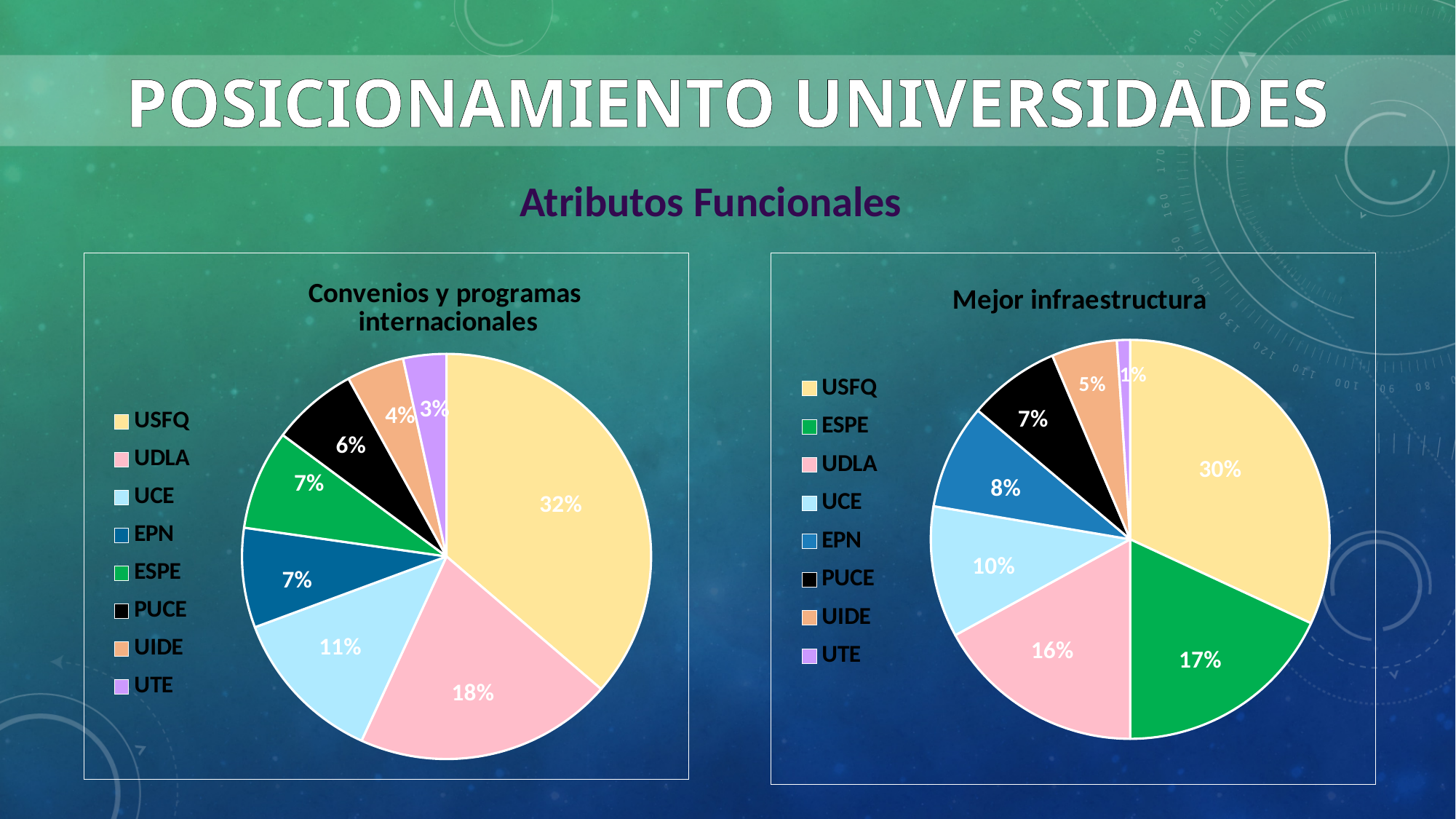
In the 'Mejor infraestructura' chart, what is the difference between the USFQ share and the UDLA share? 14% What kind of chart is 'Convenios y programas internacionales'? Pie chart In the 'Convenios y programas internacionales' chart, which is larger, the UDLA share or the UCE share? UDLA In the 'Mejor infraestructura' chart, which university has the smallest slice? UTE In the 'Mejor infraestructura' chart, what share does UTE have? 1% In the 'Convenios y programas internacionales' chart, what share does PUCE have? 6% In the 'Mejor infraestructura' chart, what share does ESPE have? 17% What is the title of the chart on the right side of the slide? Mejor infraestructura In the 'Convenios y programas internacionales' chart, which university has the largest slice? USFQ How many universities are shown in the 'Mejor infraestructura' chart? 8 In the 'Convenios y programas internacionales' chart, which university has the smallest slice? UTE In the 'Convenios y programas internacionales' chart, what share does USFQ have? 32%